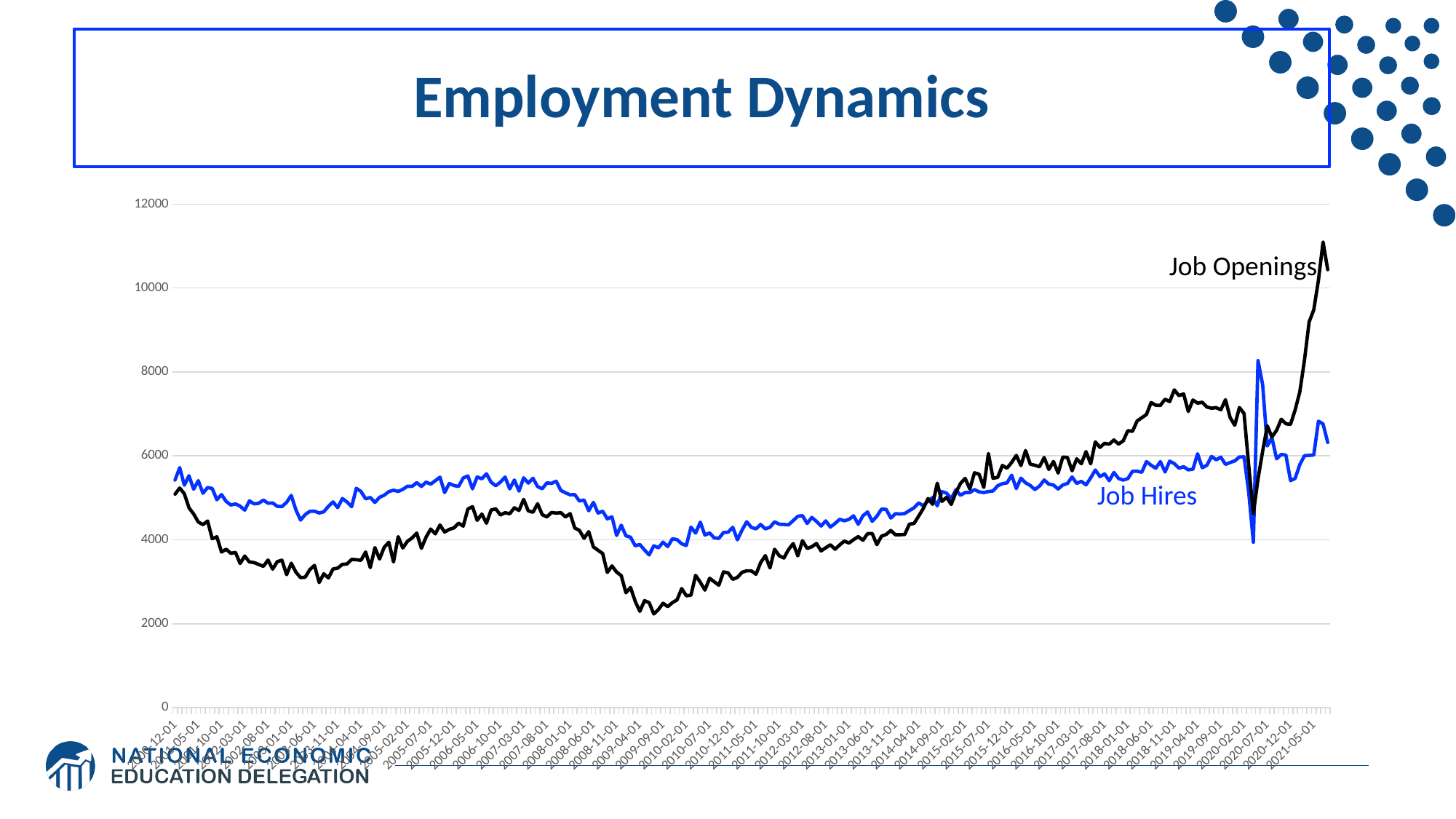
What is the title of the chart on the slide? Employment Dynamics Which series reaches the highest value anywhere on the chart? Job Openings Does the Job Openings line generally rise or fall between 2009-09-01 and 2018-11-01? Rise Around 2018-11-01, which series has the higher value, Job Openings or Job Hires? Job Openings Is the peak value of Job Openings in 2021 greater or less than 10000? greater Is the lowest value of Job Openings around 2009 greater or less than 4000? less How many data series are plotted on the chart? 2 Around 2009-04-01, which series has the higher value, Job Openings or Job Hires? Job Hires Is the value of Job Openings at 2000-12-01 greater or less than 4000? greater Does the Job Openings line generally rise or fall between 2007-08-01 and 2009-04-01? Fall What kind of chart is shown on the slide? Line chart Which colour is used for the Job Hires line? Blue